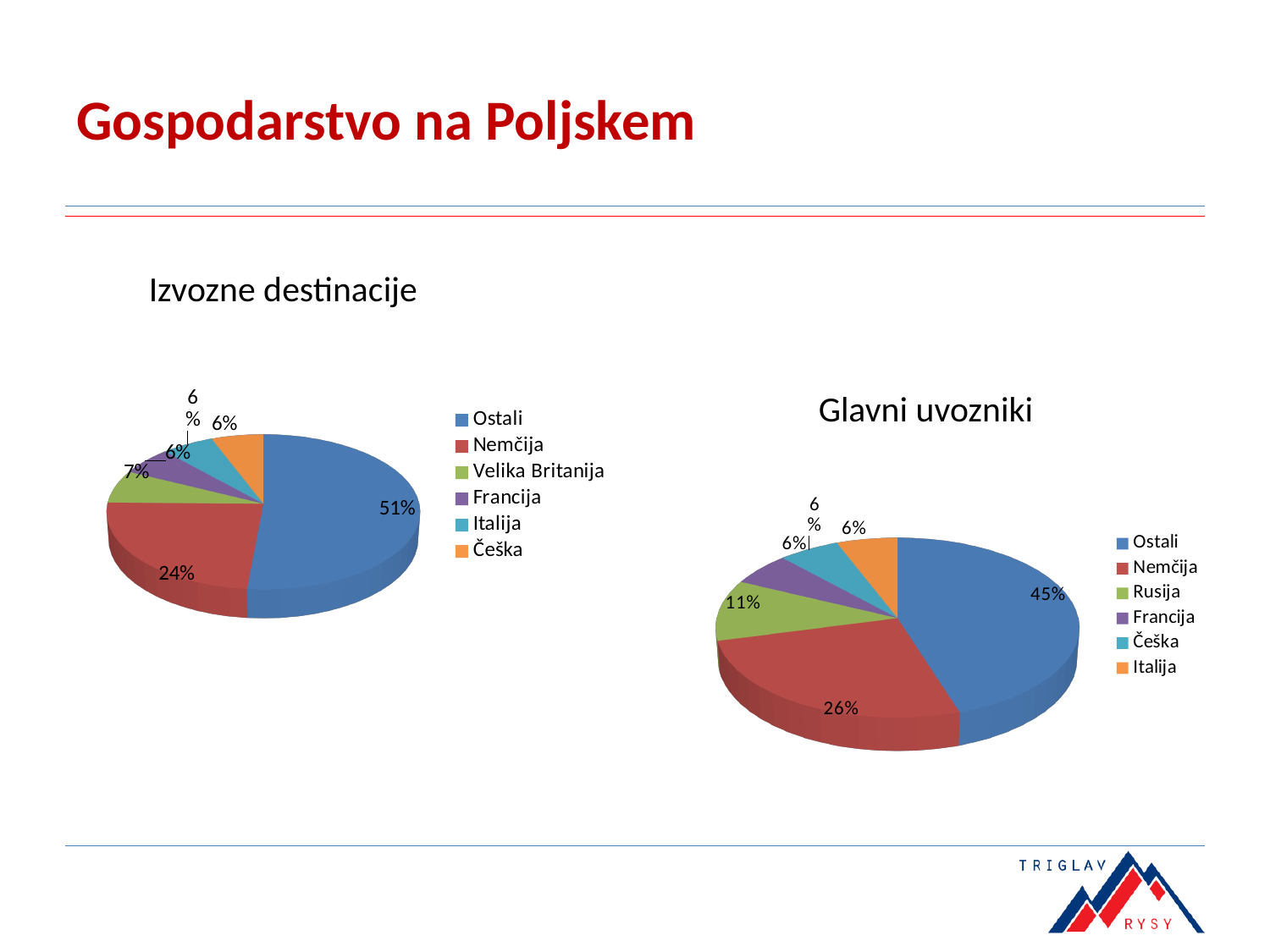
In the 'Izvozne destinacije' chart, which category has the largest slice? Ostali In the 'Izvozne destinacije' chart, what is the difference between the shares of Ostali and Nemčija? 27% What type of chart is 'Izvozne destinacije'? Pie chart In the 'Izvozne destinacije' chart, what share does Nemčija have? 24% In the 'Glavni uvozniki' chart, what share does Ostali have? 45% How many categories does the legend of the 'Glavni uvozniki' chart list? 6 In the 'Glavni uvozniki' chart, which category has the second largest slice? Nemčija In the 'Glavni uvozniki' chart, which is larger, the share of Rusija or the share of Francija? Rusija In the 'Izvozne destinacije' chart, what share does Velika Britanija have? 7% In the 'Glavni uvozniki' chart, what share does Nemčija have? 26% In the 'Glavni uvozniki' chart, what share does Rusija have? 11% In the 'Izvozne destinacije' chart, what share does Ostali have? 51%